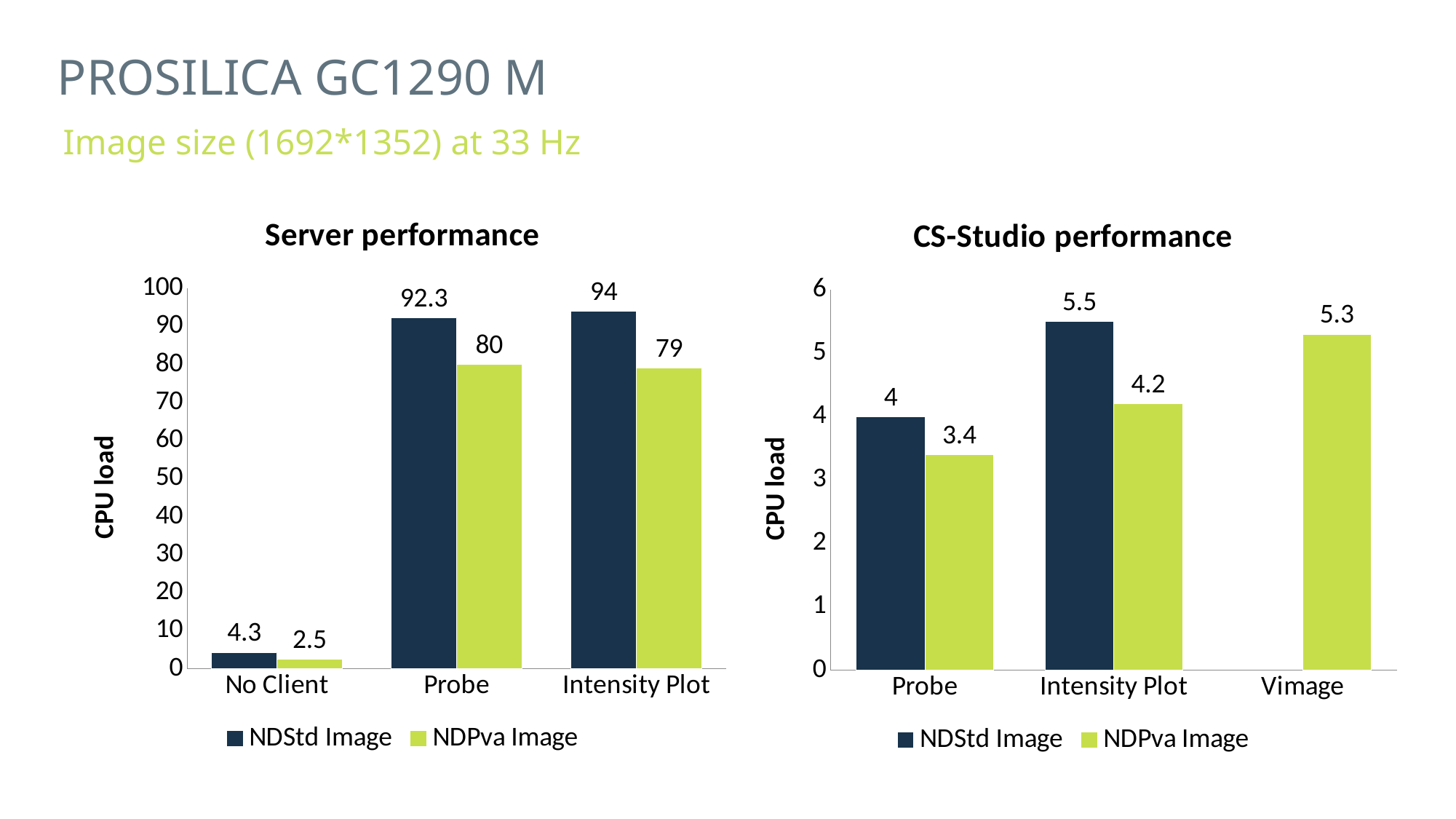
In the CS-Studio performance chart, which is larger at Probe: NDStd Image or NDPva Image? NDStd Image In the CS-Studio performance chart, what is the CPU load for NDPva Image at Vimage? 5.3 What kind of chart is the Server performance chart? Bar chart In the CS-Studio performance chart, what is the CPU load for NDStd Image at Intensity Plot? 5.5 In the CS-Studio performance chart, what is the difference between the NDStd Image and NDPva Image values at Intensity Plot? 1.3 In the CS-Studio performance chart, how many series does the legend list? 2 In the Server performance chart, how many categories are shown on the x axis? 3 In the Server performance chart, which category has the lowest NDPva Image value? No Client In the Server performance chart, what is the CPU load for NDPva Image at Intensity Plot? 79 What is the y-axis label of the CS-Studio performance chart? CPU load In the Server performance chart, what is the CPU load for NDStd Image at Probe? 92.3 In the Server performance chart, what is the difference between the NDStd Image and NDPva Image values at Probe? 12.3